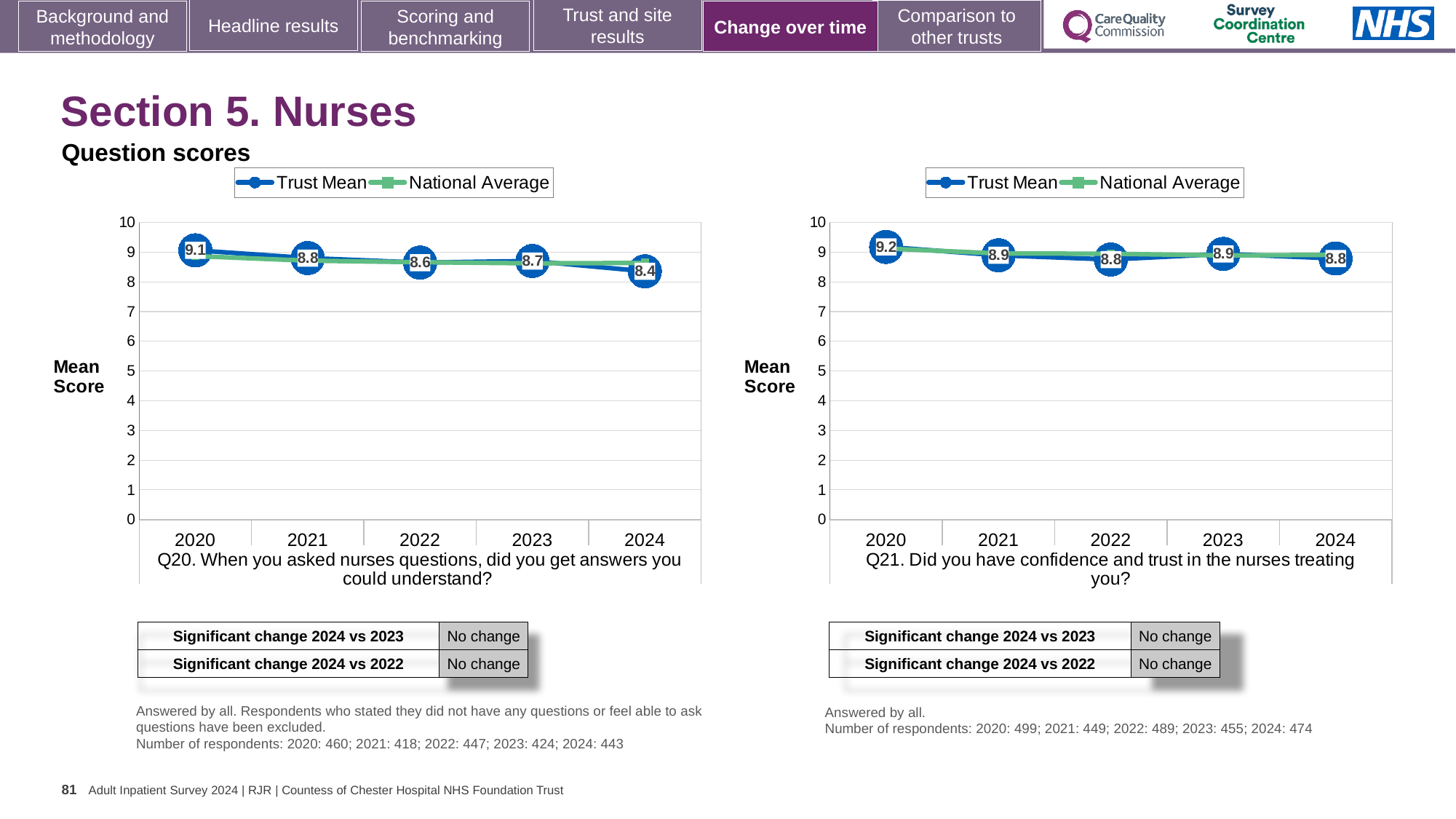
On the Q21 chart, what is the Trust Mean score for 2022? 8.8 On the Q21 chart, what is the difference between the Trust Mean scores for 2020 and 2024? 0.4 On the Q20 chart, is the Trust Mean score for 2021 or 2022 larger? 2021 On the Q20 chart, what is the difference between the Trust Mean scores for 2020 and 2024? 0.7 On the Q20 chart, which year has the highest Trust Mean score? 2020 How many years are plotted on the Q21 chart? 5 On the Q20 chart, what is the Trust Mean score for 2024? 8.4 On the Q20 chart, which year has the lowest Trust Mean score? 2024 On the Q21 chart, what is the Trust Mean score for 2020? 9.2 On the Q21 chart, which year has the highest Trust Mean score? 2020 On the Q20 chart, what is the Trust Mean score for 2020? 9.1 How many series does the legend of the Q20 chart list? 2